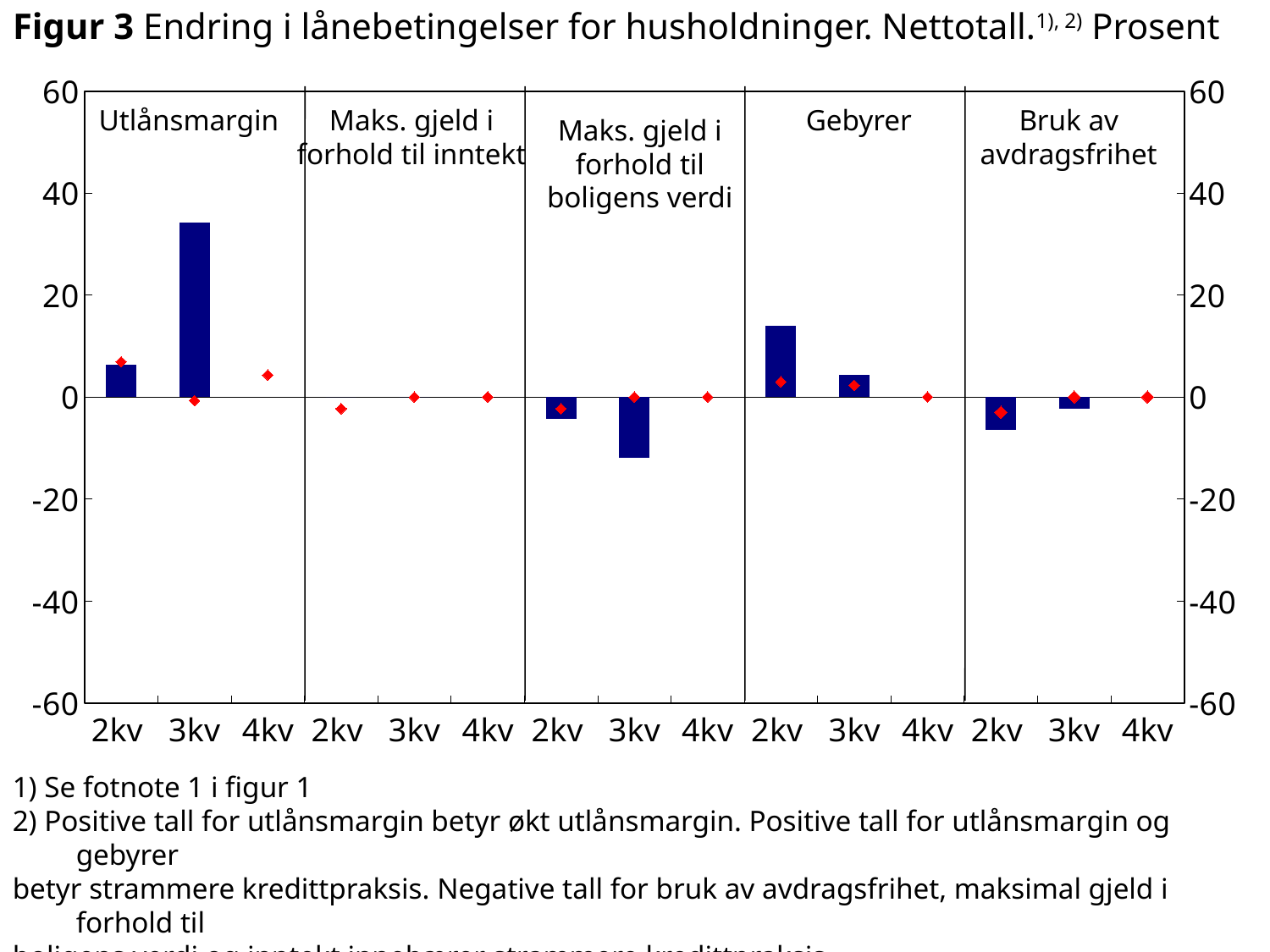
For Gebyrer, which quarter has the larger bar, 2kv or 3kv? 2kv What are the minimum and maximum values shown on the y axis? -60 and 60 How many quarters are shown on the x axis within each panel? 3 For Utlånsmargin, which quarter has the larger bar, 2kv or 3kv? 3kv Which bar is the lowest in the whole chart? Maks. gjeld i forhold til boligens verdi, 3kv Is the value for Gebyrer in 2kv greater or less than 20? less Is the value for Maks. gjeld i forhold til boligens verdi in 3kv greater or less than 0? less Is the value for Bruk av avdragsfrihet in 2kv greater or less than -20? greater Which bar is the highest in the whole chart? Utlånsmargin, 3kv How many panels (loan condition categories) does the chart have? 5 What kind of chart is shown in Figur 3? bar chart